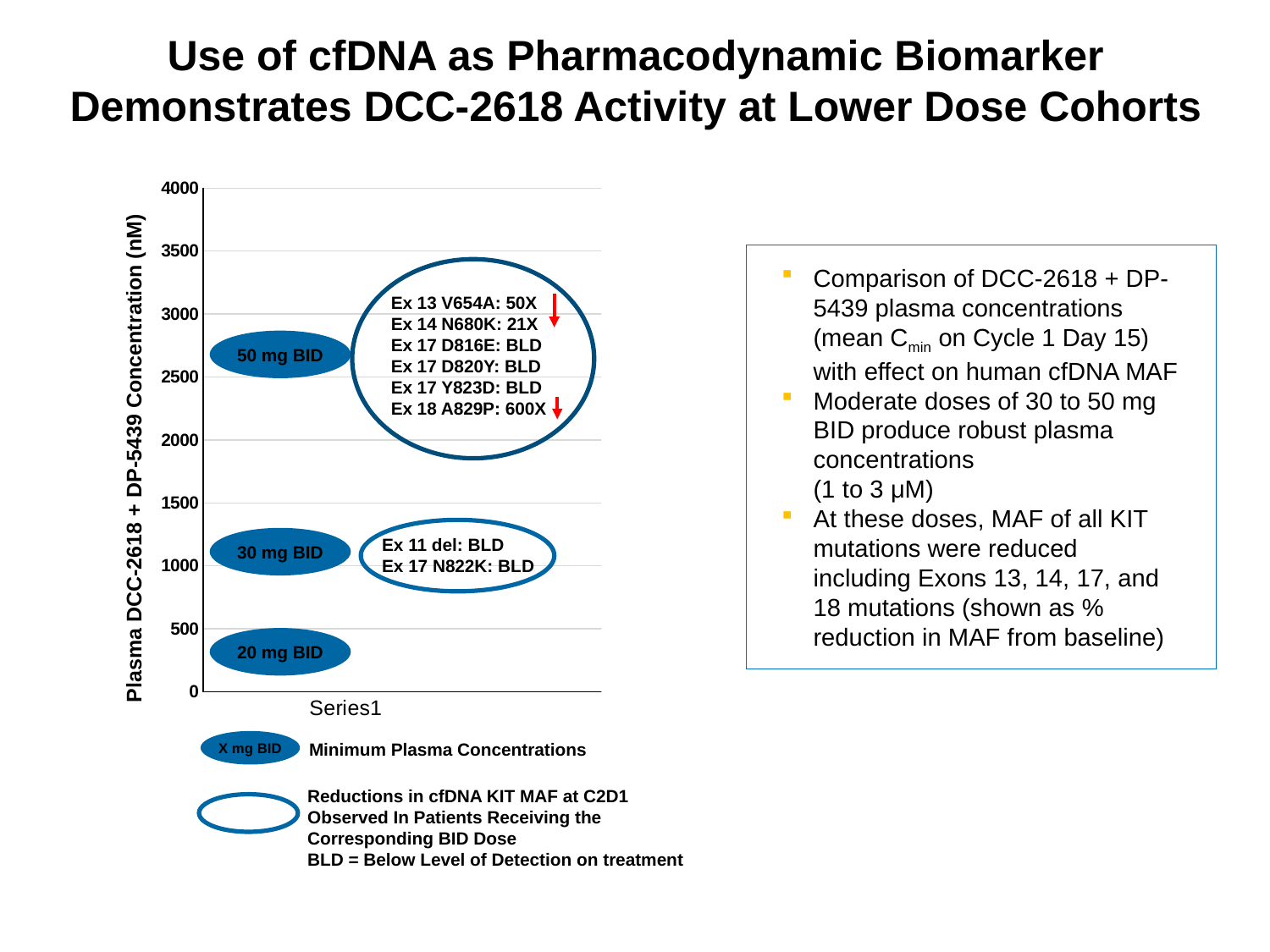
Do the plotted plasma concentrations rise or fall as the BID dose increases from 20 mg to 50 mg? rise What is the y-axis title of the chart? Plasma DCC-2618 + DP-5439 Concentration (nM) What is the maximum value shown on the y axis of the chart? 4000 Which dose cohort is plotted at the lowest plasma concentration on the chart? 20 mg BID Is the plasma concentration for the 30 mg BID cohort greater or less than 1500 nM? less How many dose cohorts are plotted on the chart? 3 Is the plasma concentration for the 20 mg BID cohort greater or less than 1000 nM? less How many KIT mutations are listed in the oval next to the 50 mg BID cohort? 6 What reduction in cfDNA MAF is listed for Ex 18 A829P in the 50 mg BID cohort? 600X Which cohort has the higher plasma concentration, 30 mg BID or 20 mg BID? 30 mg BID Is the plasma concentration for the 50 mg BID cohort greater or less than 2000 nM? greater Which dose cohort is plotted at the highest plasma concentration on the chart? 50 mg BID